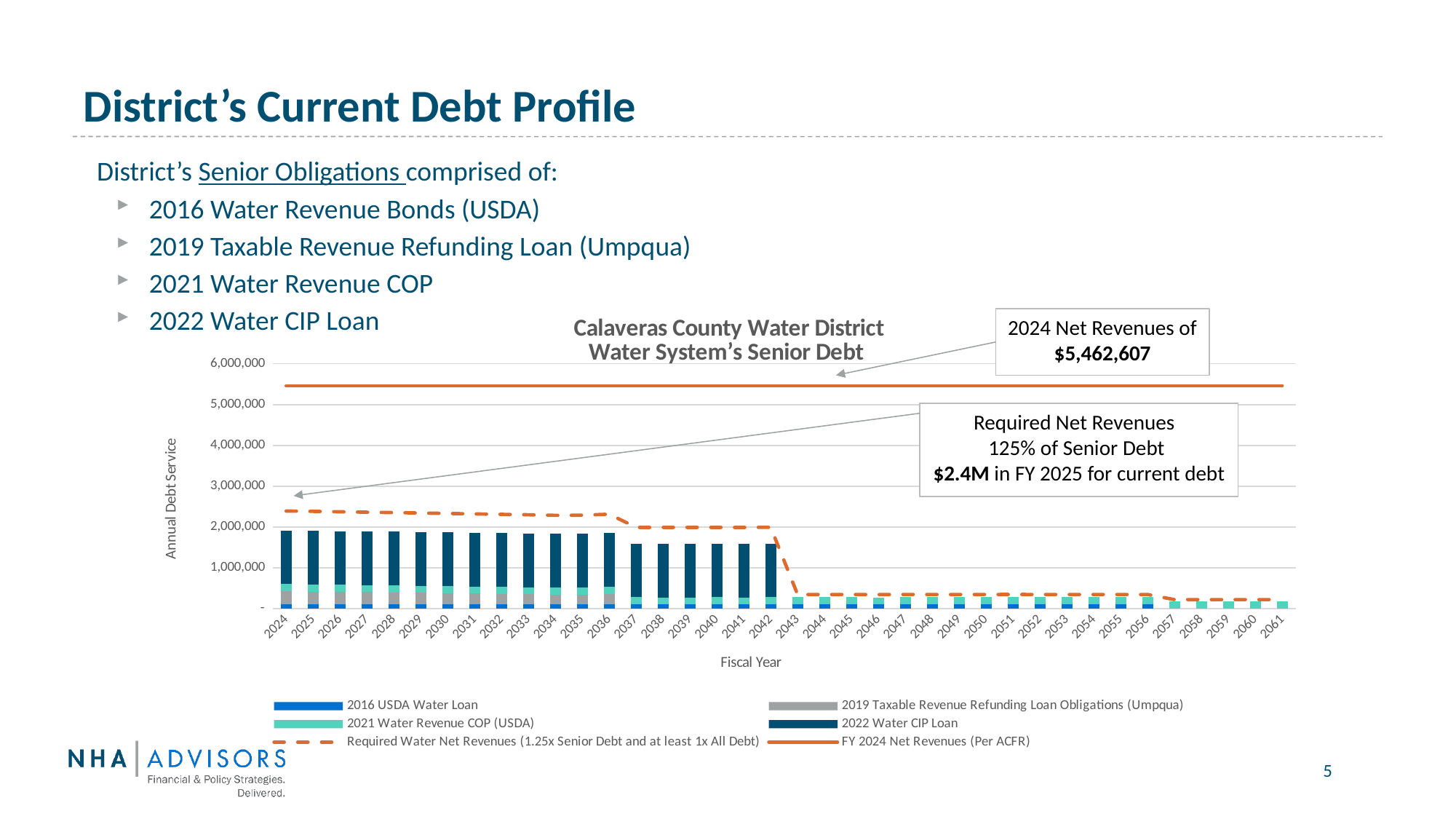
How many series does the chart's legend list? 6 According to the chart annotation, what are the required net revenues in FY 2025 for current debt? $2.4M Is the FY 2024 Net Revenues line greater or less than 5,000,000? greater What kind of chart is used to show the annual debt service by fiscal year? bar chart Is the total annual debt service for fiscal year 2040 greater or less than 2,000,000? less Which fiscal year has the larger total annual debt service, 2030 or 2045? 2030 Which series makes up the largest portion of the stacked bars from 2024 through 2042? 2022 Water CIP Loan Do the total annual debt service bars rise or fall from 2024 to 2061? fall What is the title of the chart? Calaveras County Water District Water System's Senior Debt How many fiscal years are shown on the x axis of the chart? 38 Is the total annual debt service for fiscal year 2050 greater or less than 1,000,000? less What value is given for the 2024 Net Revenues in the chart annotation? $5,462,607